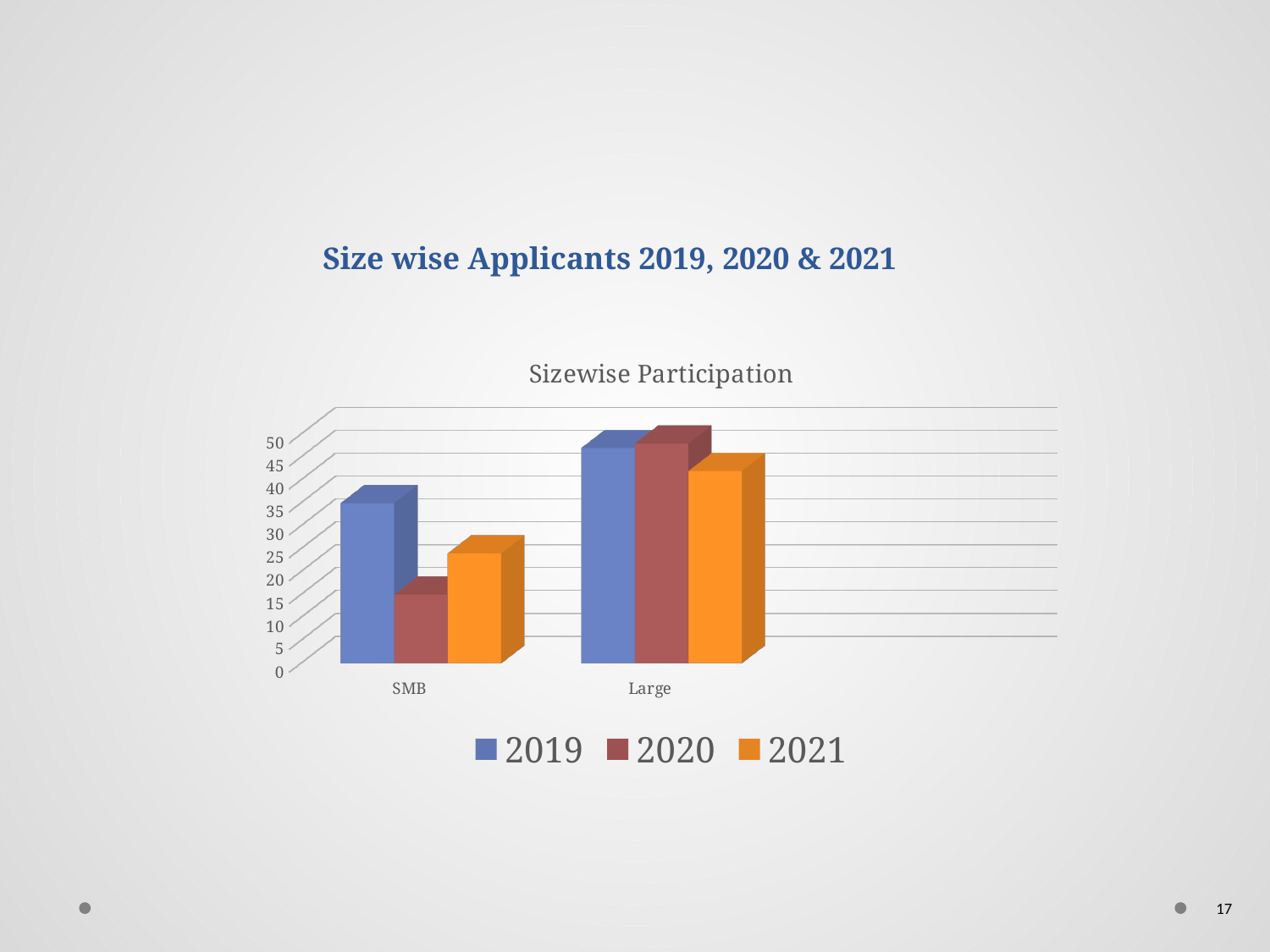
What is the title of the chart? Sizewise Participation How many series does the legend list? 3 What kind of chart is shown on the slide? bar chart For SMB, which year has the highest value? 2019 How many categories are shown on the x axis? 2 Is the value for SMB in 2019 greater or less than 25? greater Is the value for Large in 2019 greater or less than 40? greater For Large, which is larger: the 2020 value or the 2021 value? 2020 For SMB, which year has the lowest value? 2020 Is the value for Large in 2021 greater or less than 35? greater Which series is shown in orange in the legend? 2021